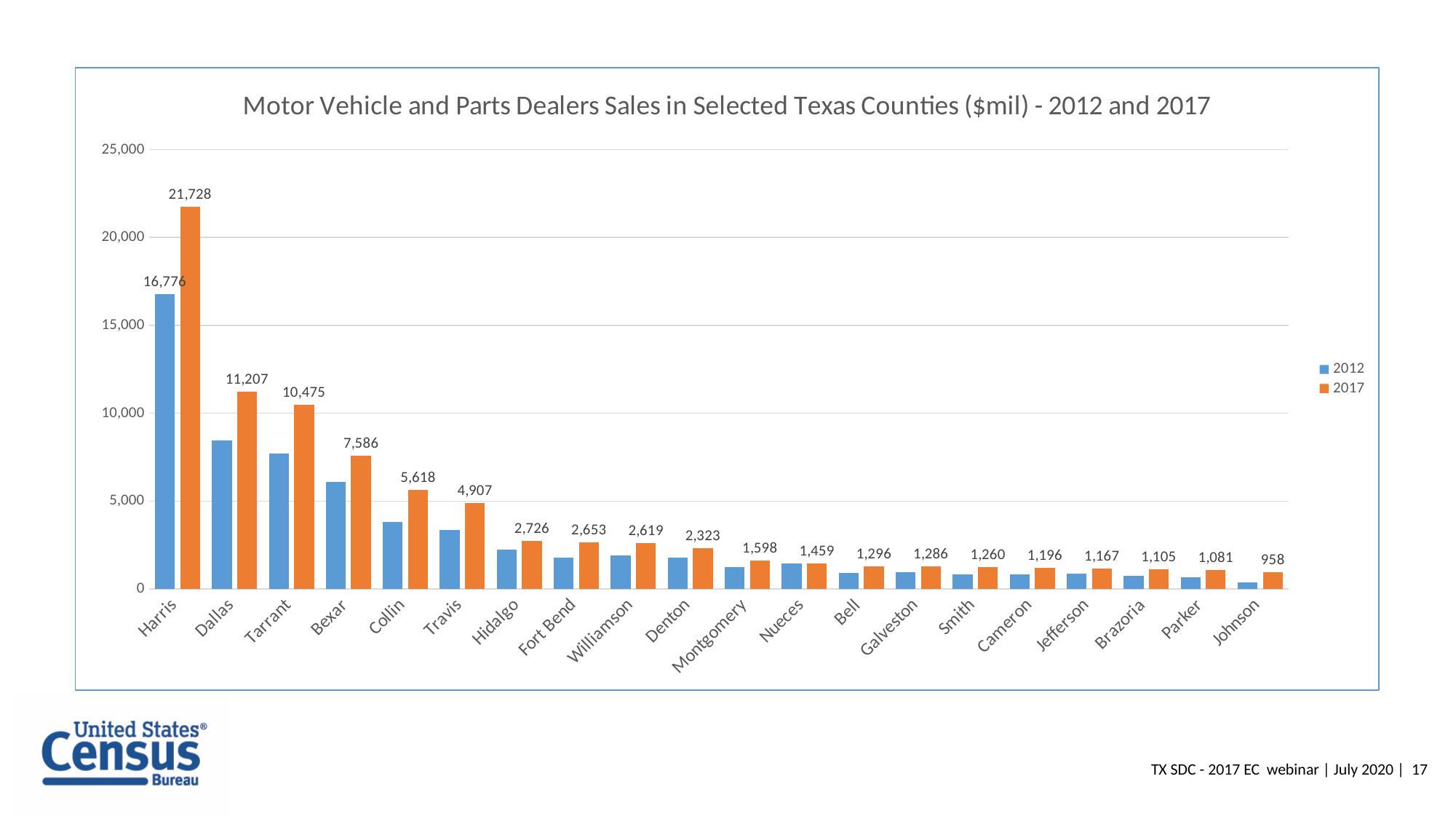
Which county has the lowest 2017 value? Johnson What was the 2012 value for Harris county? 16,776 How many series does the legend list? 2 Which county had the larger 2017 value, Tarrant or Bexar? Tarrant By how much did Harris county's value increase from 2012 to 2017? 4,952 What kind of chart is shown on the slide? Bar chart What was the 2017 value for Dallas county? 11,207 Which county has the highest 2017 value? Harris How many counties are shown on the chart? 20 Is the 2012 value for Dallas county greater or less than 10,000? less What was the 2017 value for Harris county? 21,728 What was the 2017 value for Travis county? 4,907